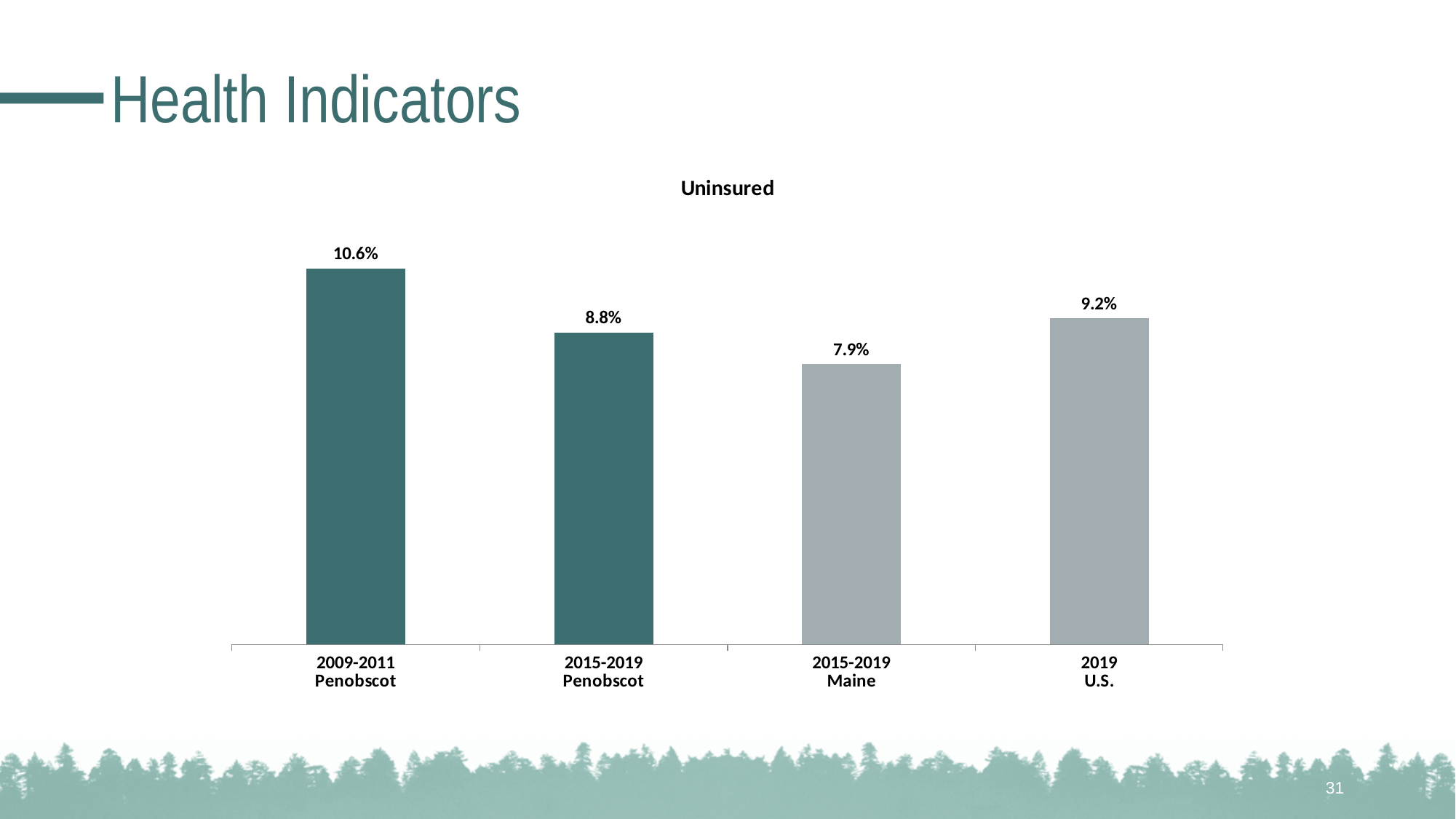
What is the uninsured rate for 2019 U.S.? 9.2% What kind of chart is shown on the slide? Bar chart Which has a higher uninsured rate, 2015-2019 Penobscot or 2019 U.S.? 2019 U.S. What is the uninsured rate for 2015-2019 Maine? 7.9% What is the difference in uninsured rate between 2019 U.S. and 2015-2019 Maine? 1.3% What is the difference in uninsured rate between 2009-2011 Penobscot and 2015-2019 Penobscot? 1.8% Which category has the highest uninsured rate? 2009-2011 Penobscot How many categories are shown in the chart? 4 What is the uninsured rate for 2009-2011 Penobscot? 10.6% Which category has the lowest uninsured rate? 2015-2019 Maine What is the uninsured rate for 2015-2019 Penobscot? 8.8% What is the title of the chart? Uninsured